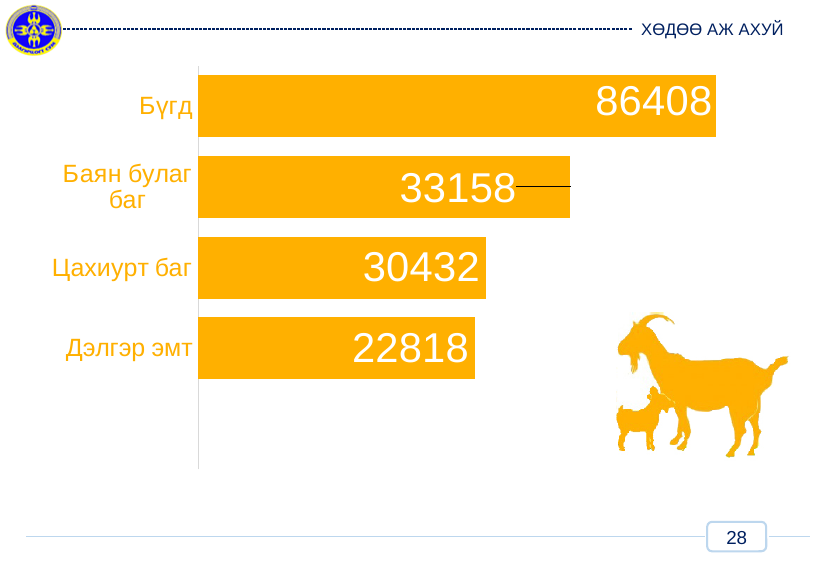
What is the value for Баян булаг баг? 33158 What colour are the bars in the chart? orange What is the difference between the values for Баян булаг баг and Цахиурт баг? 2726 Which is larger, the value for Цахиурт баг or the value for Дэлгэр эмт? Цахиурт баг How many categories are shown in the chart? 4 What is the value for Дэлгэр эмт? 22818 What is the difference between the values for Бүгд and Дэлгэр эмт? 63590 Which category has the highest value? Бүгд What is the value for Цахиурт баг? 30432 Which category has the lowest value? Дэлгэр эмт What is the value for Бүгд? 86408 What kind of chart is shown on the slide? bar chart